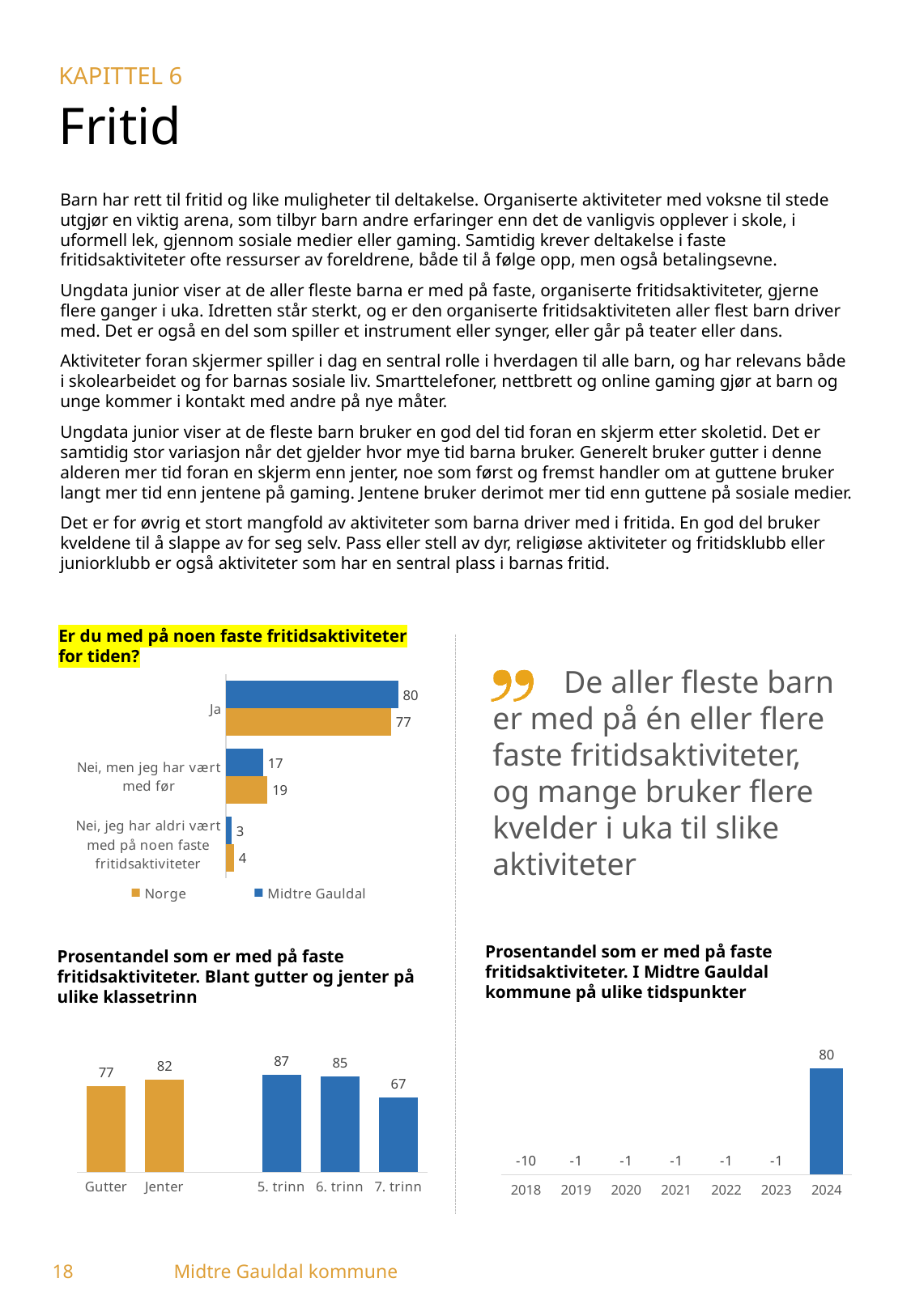
What kind of chart is 'Er du med på noen faste fritidsaktiviteter for tiden?'? Bar chart In the chart 'Er du med på noen faste fritidsaktiviteter for tiden?', what is the value for Norge for 'Nei, men jeg har vært med før'? 19 In the chart 'Prosentandel som er med på faste fritidsaktiviteter. Blant gutter og jenter på ulike klassetrinn', what is the value for Jenter? 82 In the chart 'Prosentandel som er med på faste fritidsaktiviteter. Blant gutter og jenter på ulike klassetrinn', which category has the highest value? 5. trinn In the chart 'Prosentandel som er med på faste fritidsaktiviteter. Blant gutter og jenter på ulike klassetrinn', what is the difference between 6. trinn and 7. trinn? 18 In the chart 'Er du med på noen faste fritidsaktiviteter for tiden?', which series is shown in orange? Norge In the chart 'Er du med på noen faste fritidsaktiviteter for tiden?', what is the value for Midtre Gauldal for 'Ja'? 80 In the chart 'Prosentandel som er med på faste fritidsaktiviteter. Blant gutter og jenter på ulike klassetrinn', which category has the lowest value? 7. trinn In the chart 'Er du med på noen faste fritidsaktiviteter for tiden?', what is the difference between the Midtre Gauldal and Norge values for 'Ja'? 3 In the chart 'Er du med på noen faste fritidsaktiviteter for tiden?', how many series does the legend list? 2 In the chart 'Prosentandel som er med på faste fritidsaktiviteter. I Midtre Gauldal kommune på ulike tidspunkter', how many years are shown on the x axis? 7 In the chart 'Prosentandel som er med på faste fritidsaktiviteter. I Midtre Gauldal kommune på ulike tidspunkter', what is the value for 2024? 80